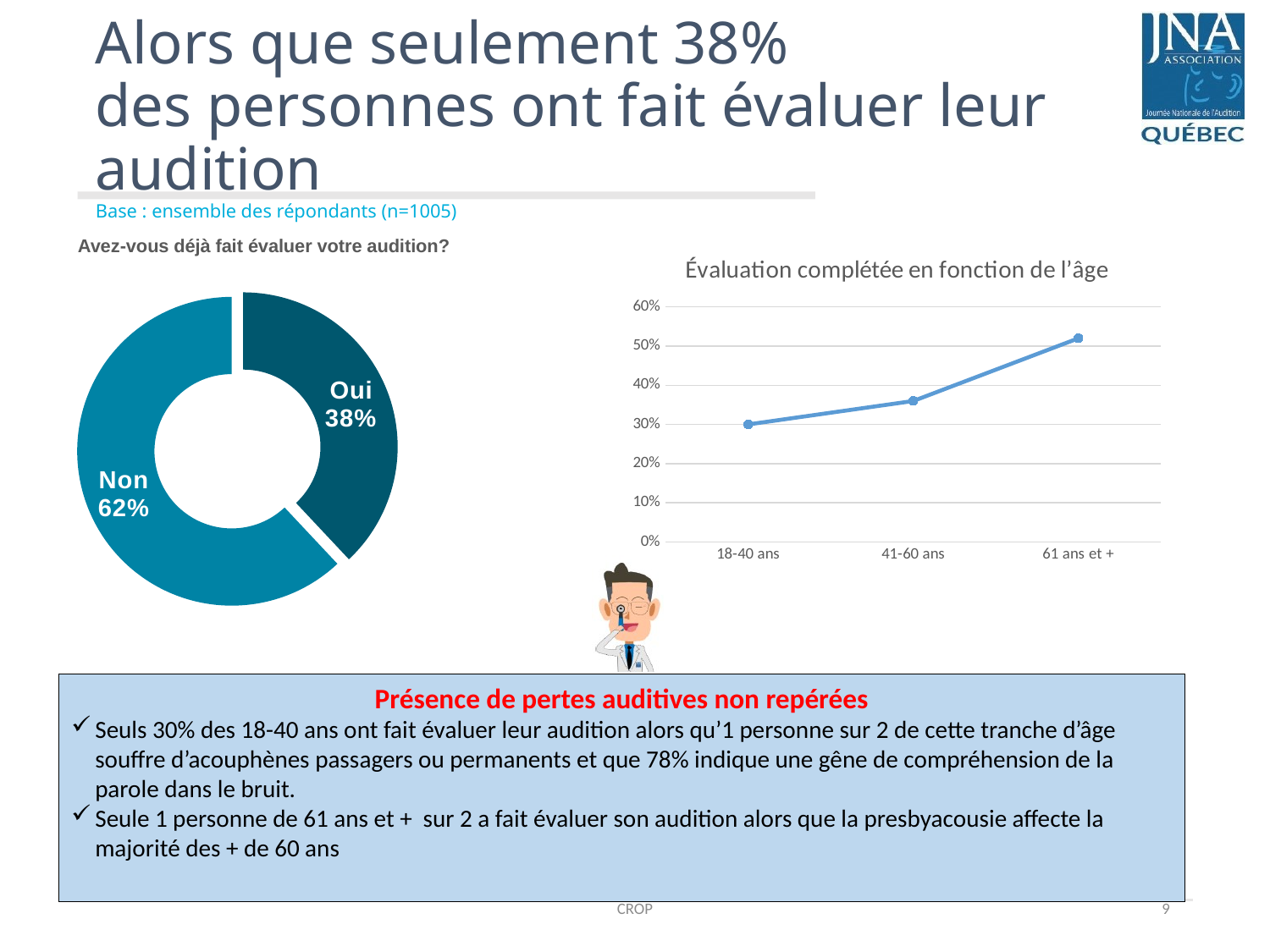
In the donut chart on the left, what is the difference in percentage points between "Non" and "Oui"? 24 percentage points How many age categories are plotted in the chart "Évaluation complétée en fonction de l'âge"? 3 What kind of chart is the chart titled "Évaluation complétée en fonction de l'âge"? Line chart In the chart "Évaluation complétée en fonction de l'âge", do the values rise or fall from "18-40 ans" to "61 ans et +"? Rise In the chart "Évaluation complétée en fonction de l'âge", which age group has the highest value? 61 ans et + In the chart "Évaluation complétée en fonction de l'âge", which age group has the lowest value? 18-40 ans In the donut chart on the left, what percentage of respondents answered "Non"? 62% How many slices does the donut chart on the left have? 2 In the donut chart on the left, which answer has the larger share? Non In the chart "Évaluation complétée en fonction de l'âge", is the value for "41-60 ans" greater or less than 40%? less In the chart "Évaluation complétée en fonction de l'âge", is the value for "61 ans et +" greater or less than 50%? greater In the donut chart on the left, what percentage of respondents answered "Oui"? 38%